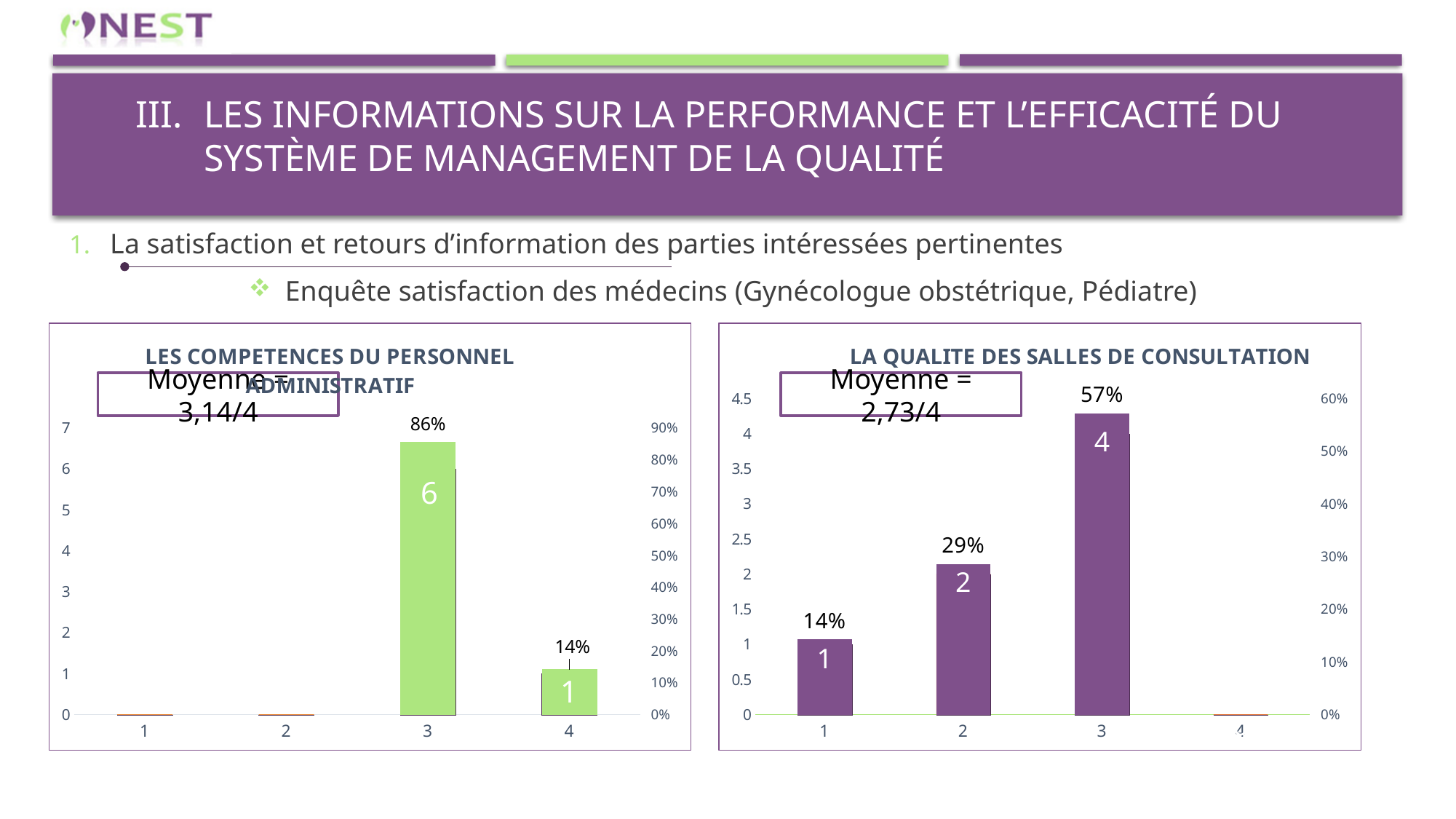
What average (Moyenne) is shown on the chart titled 'LA QUALITE DES SALLES DE CONSULTATION'? 2,73/4 In the chart titled 'LES COMPETENCES DU PERSONNEL ADMINISTRATIF', how many categories are shown on the x axis? 4 In the chart titled 'LES COMPETENCES DU PERSONNEL ADMINISTRATIF', what is the difference between the counts for category 3 and category 4? 5 In the chart titled 'LES COMPETENCES DU PERSONNEL ADMINISTRATIF', what percentage is shown above the bar for category 4? 14% In the chart titled 'LA QUALITE DES SALLES DE CONSULTATION', what percentage is shown above the bar for category 3? 57% In the chart titled 'LA QUALITE DES SALLES DE CONSULTATION', what is the difference between the percentages for category 3 and category 2? 28% In the chart titled 'LA QUALITE DES SALLES DE CONSULTATION', which category has the highest bar? 3 In the chart titled 'LA QUALITE DES SALLES DE CONSULTATION', is the count for category 1 larger or the count for category 3? category 3 In the chart titled 'LA QUALITE DES SALLES DE CONSULTATION', what is the count shown for category 2? 2 In the chart titled 'LES COMPETENCES DU PERSONNEL ADMINISTRATIF', what is the count shown for category 3? 6 What kind of chart is 'LA QUALITE DES SALLES DE CONSULTATION'? bar chart In the chart titled 'LES COMPETENCES DU PERSONNEL ADMINISTRATIF', which category has the highest bar? 3